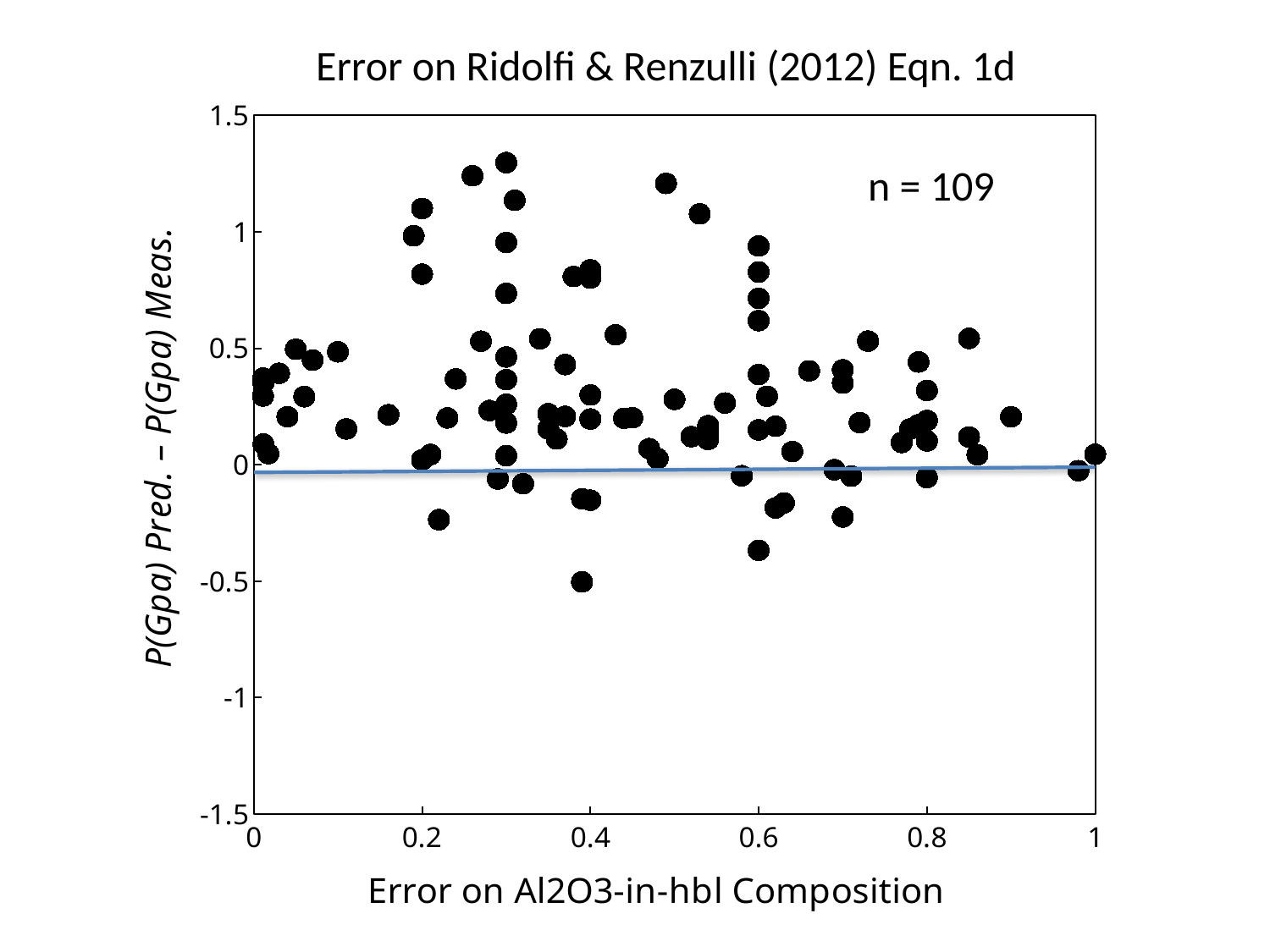
Are most of the plotted points above or below 0 on the y axis? above What is the label of the x axis? Error on Al2O3-in-hbl Composition How many data points does the chart report (n)? 109 What kind of chart is shown on the slide? Scatter plot Does the fitted line rise steeply, fall steeply, or stay roughly flat across the x axis? roughly flat What is the title of the chart? Error on Ridolfi & Renzulli (2012) Eqn. 1d Is the value of the lowest point on the chart greater or less than 0? less How many series of points are plotted on the chart? 1 Is the value of the highest point on the chart greater or less than 1? greater